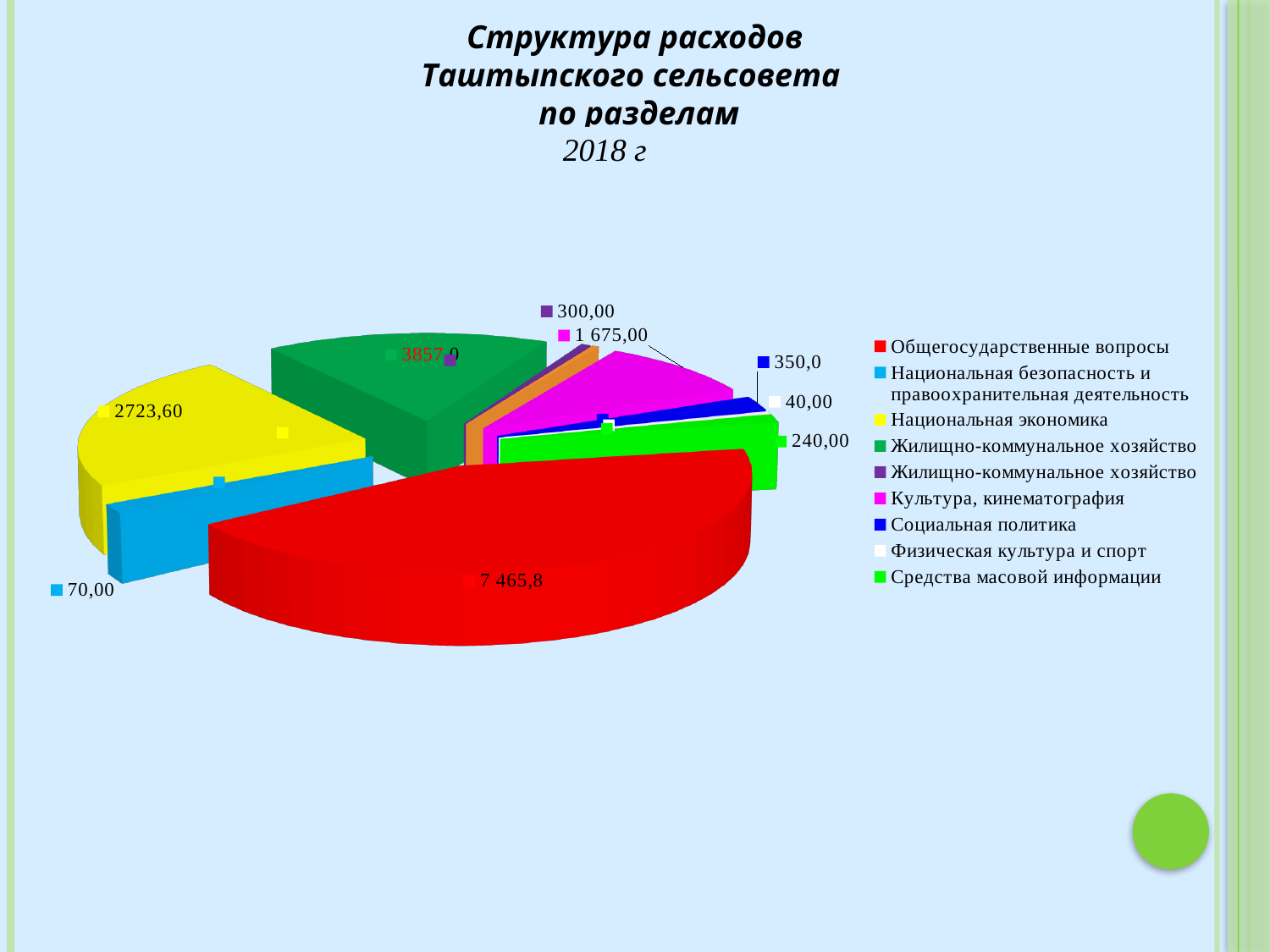
What is the difference between the values for Социальная политика and Средства масовой информации? 110,0 What is the value for Общегосударственные вопросы? 7 465,8 Which category has the smallest value? Физическая культура и спорт What type of chart is shown on the slide? Pie chart Which category has the largest value? Общегосударственные вопросы What is the value for Социальная политика? 350,0 What is the value for Национальная экономика? 2723,60 What is the value for Культура, кинематография? 1 675,00 What is the value for Национальная безопасность и правоохранительная деятельность? 70,00 Which is larger, the value for Национальная экономика or the value for Культура, кинематография? Национальная экономика How many entries does the legend list? 9 What is the value for Средства масовой информации? 240,00